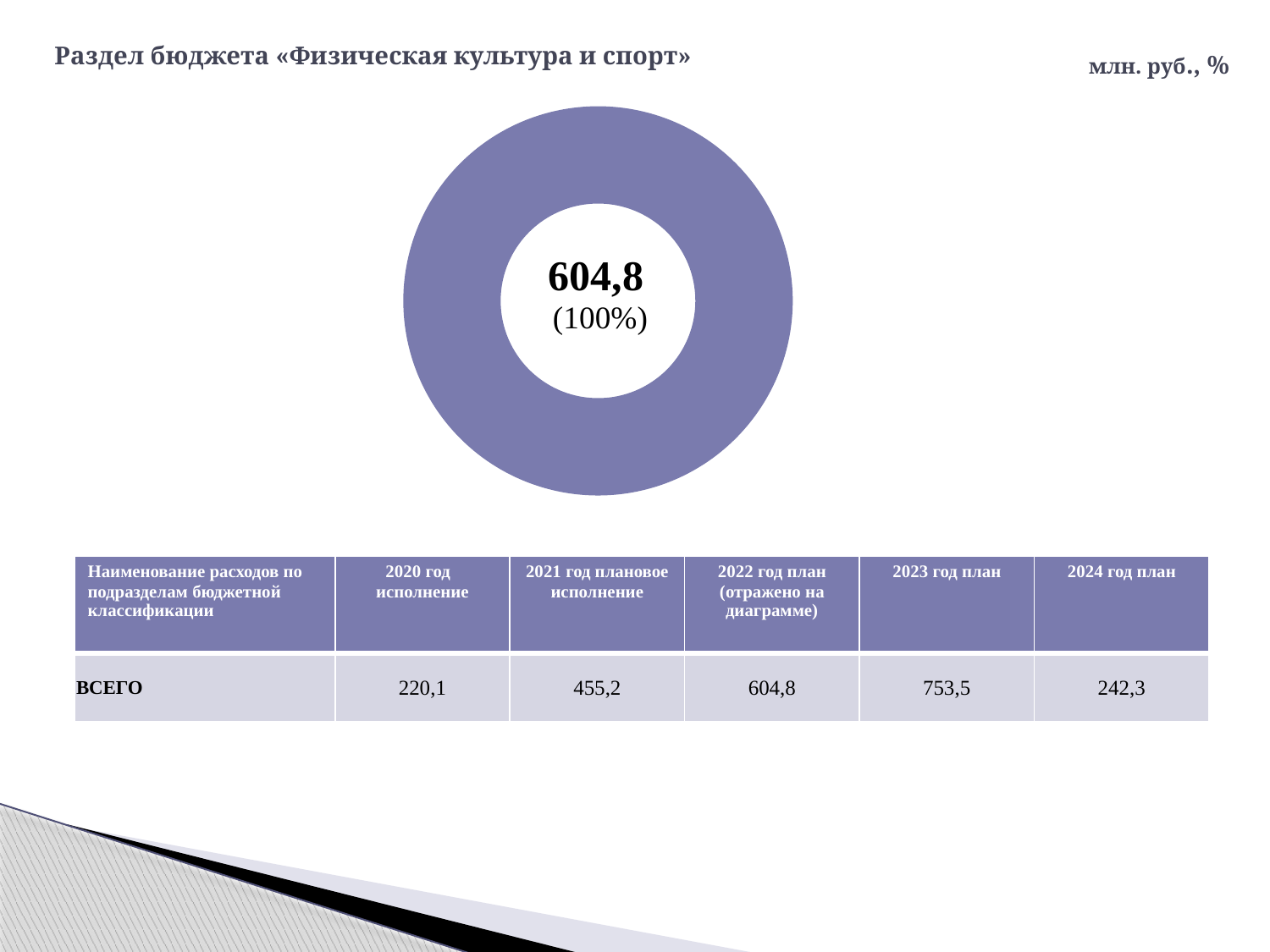
What value is printed in the centre of the donut chart? 604,8 What kind of chart is shown on the slide? Pie (donut) chart Is the value shown in the donut chart greater or less than 600? greater In what units are the values on the slide expressed, according to the label in the top right corner? млн. руб., % How many segments does the donut chart contain? 1 What is the title of the slide containing the donut chart? Раздел бюджета «Физическая культура и спорт» What percentage share is shown for the single segment of the donut chart? 100% Which year's plan does the donut chart reflect, according to the table header? 2022 год план